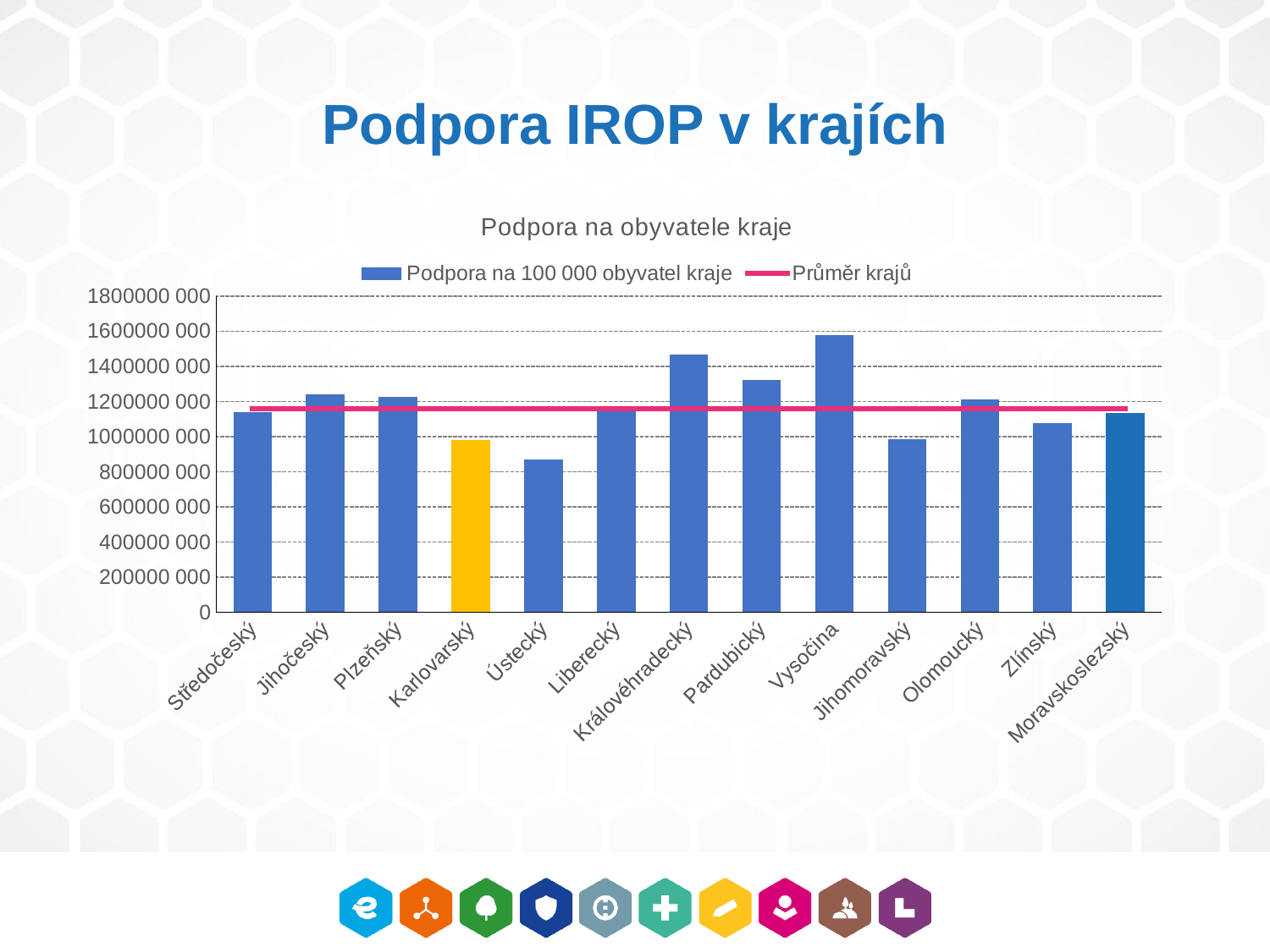
How many regions (categories) are shown on the x axis? 13 What kind of chart is shown on the slide? combination bar and line chart Which region has the lowest value for Podpora na 100 000 obyvatel kraje? Ústecký How many series does the legend list? 2 Which region has the highest value for Podpora na 100 000 obyvatel kraje? Vysočina Which is larger, the value for Pardubický or the value for Jihomoravský? Pardubický Is the value for Královéhradecký greater or less than 1400000 000? greater Which region's bar is coloured yellow instead of blue? Karlovarský What is the title of the chart? Podpora na obyvatele kraje Which is larger, the value for Karlovarský or the value for Zlínský? Zlínský Is the value for Ústecký greater or less than 1000000 000? less